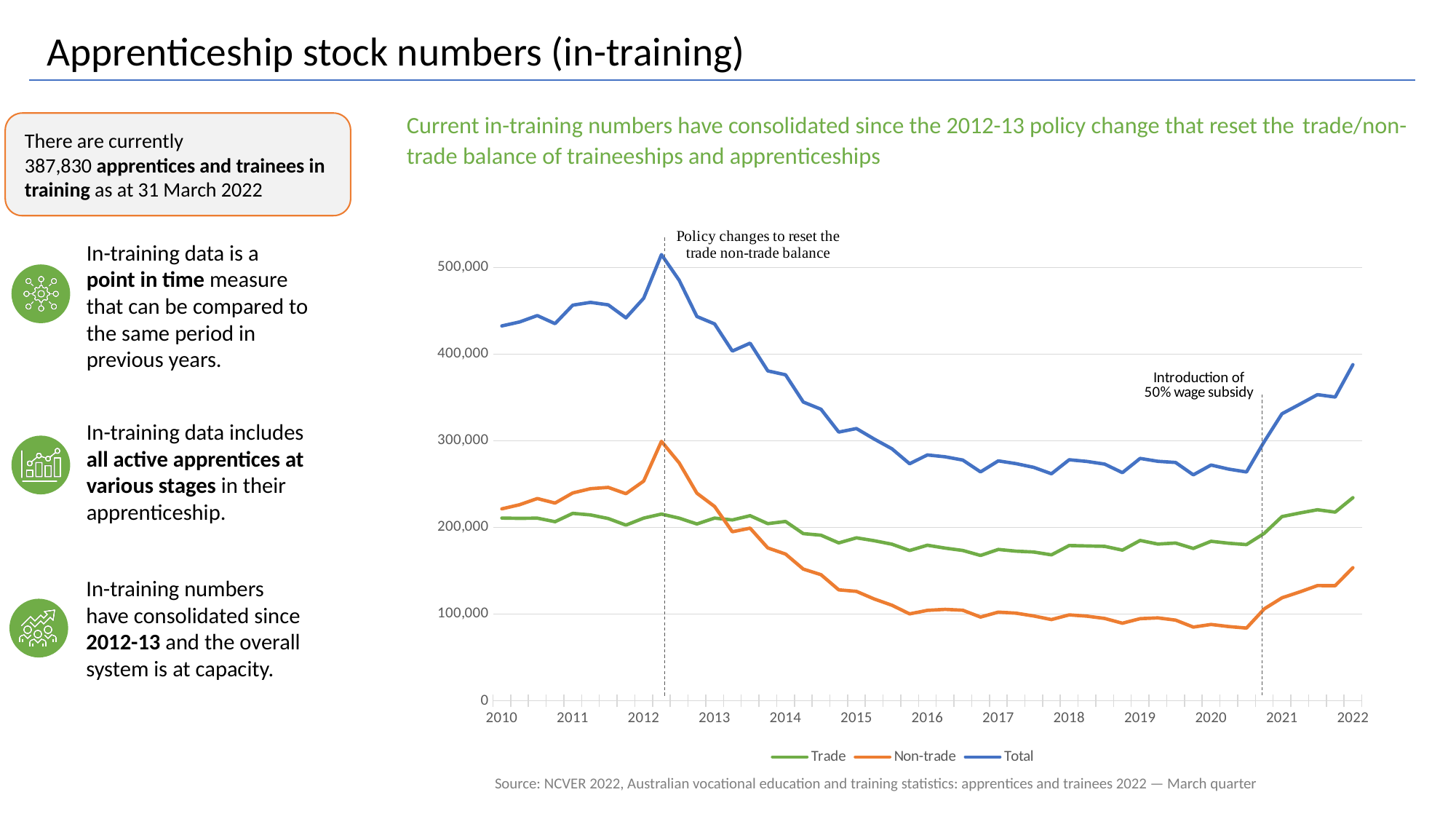
How many series does the chart legend list? 3 In which year does the Total series reach its peak? 2012 What event does the dashed vertical line near 2020-2021 mark? Introduction of 50% wage subsidy Is the value for Trade in 2022 greater or less than 200,000? greater Which series has the highest values throughout the chart? Total Is the value for Total in 2022 greater or less than 300,000? greater In 2022, which series is larger, Trade or Non-trade? Trade What kind of chart is shown on the slide? Line chart Is the value for Non-trade in 2020 greater or less than 100,000? less Does the Total series rise or fall between 2012 and 2016? Fall Does the Total series rise or fall between 2020 and 2022? Rise